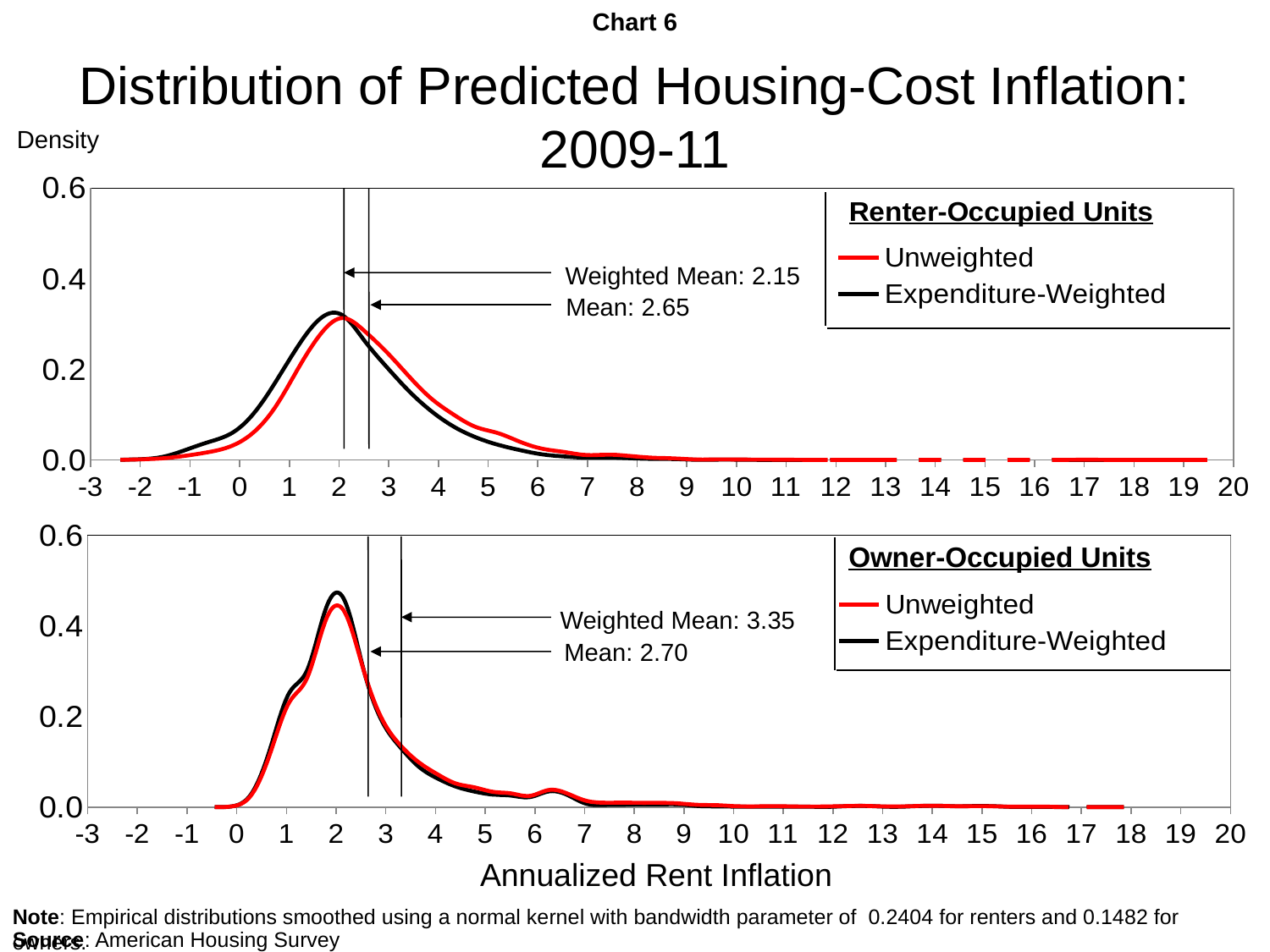
On the Renter-Occupied Units chart, is the peak density of the Unweighted series greater or less than 0.4? less On the Owner-Occupied Units chart, what is the Weighted Mean shown in the annotation? 3.35 On the Renter-Occupied Units chart, what is the difference between the Mean and the Weighted Mean? 0.50 What kind of chart is the Owner-Occupied Units chart? Line chart On the Owner-Occupied Units chart, what is the difference between the Weighted Mean and the Mean? 0.65 What is the x-axis label shown below the Owner-Occupied Units chart? Annualized Rent Inflation On the Owner-Occupied Units chart, which is larger, the Weighted Mean or the Mean? Weighted Mean On the Renter-Occupied Units chart, what is the Mean shown in the annotation? 2.65 On the Renter-Occupied Units chart, what is the Weighted Mean shown in the annotation? 2.15 On the Owner-Occupied Units chart, is the peak density of the Expenditure-Weighted series greater or less than 0.4? greater How many series does the legend of the Renter-Occupied Units chart list? 2 On the Owner-Occupied Units chart, what is the Mean shown in the annotation? 2.70